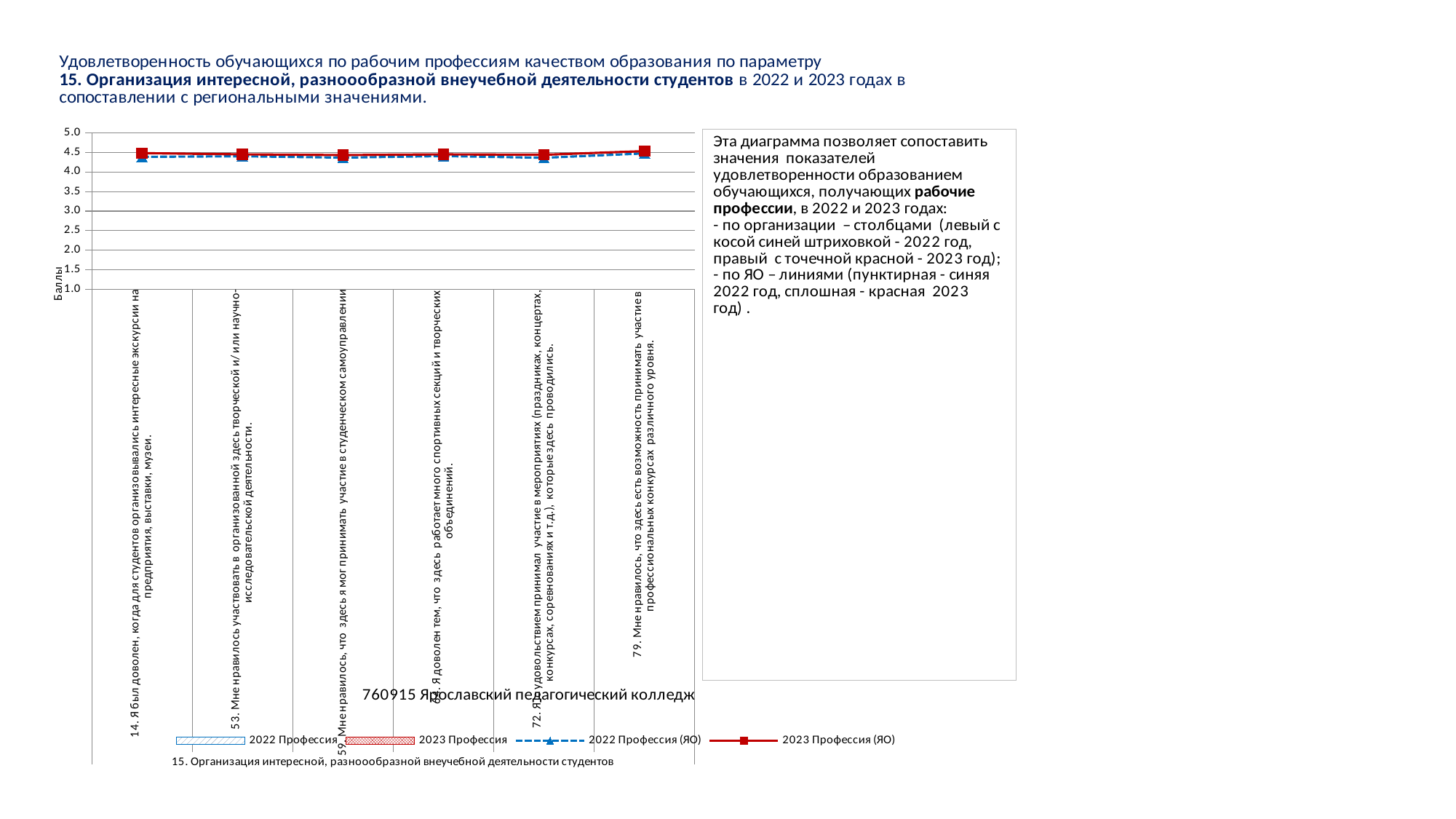
Is the value of the 2023 Профессия (ЯО) line for category 79 greater or less than 4.0? greater Is the value of the 2023 Профессия (ЯО) line for category 53 greater or less than 3.5? greater How many series does the chart legend list? 4 Is the value of the 2023 Профессия (ЯО) line for category 72 greater or less than 5.0? less How many categories are shown along the x axis of the chart? 6 What is the highest value shown on the vertical axis of the chart? 5.0 What is the label of the vertical axis of the chart? Баллы